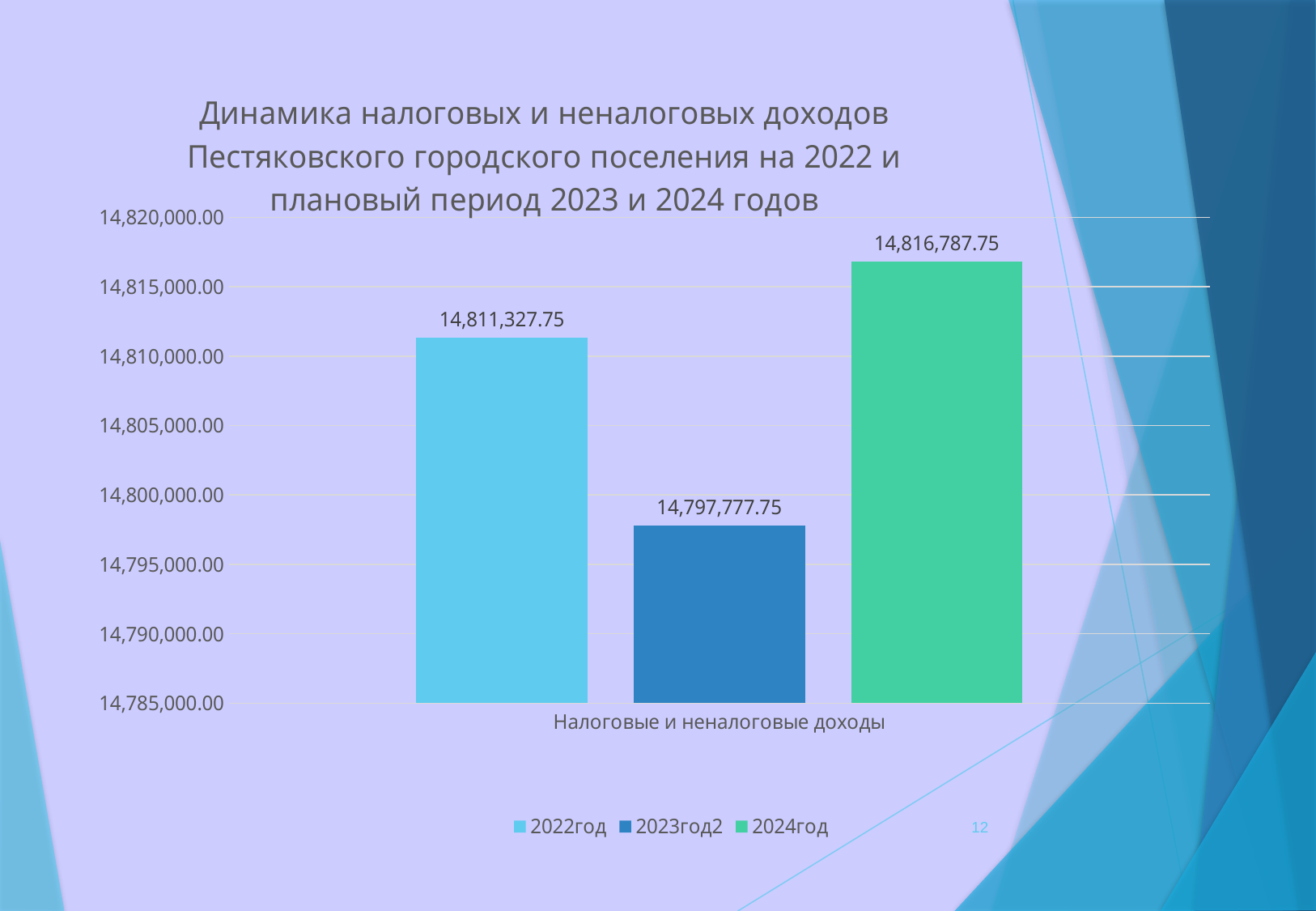
Which is larger, the value for 2022год or the value for 2023год2? 2022год What is the value for 2022год in the chart? 14,811,327.75 How many series does the legend list? 3 Is the value for 2023год2 greater or less than 14,800,000.00? less What is the value for 2024год in the chart? 14,816,787.75 What is the value for 2023год2 in the chart? 14,797,777.75 What kind of chart is shown on the slide? bar chart What is the difference between the values for 2022год and 2023год2? 13,550.00 Which series has the lowest value in the chart? 2023год2 What is the difference between the values for 2024год and 2022год? 5,460.00 What is the category label shown on the x axis of the chart? Налоговые и неналоговые доходы Which series has the highest value in the chart? 2024год